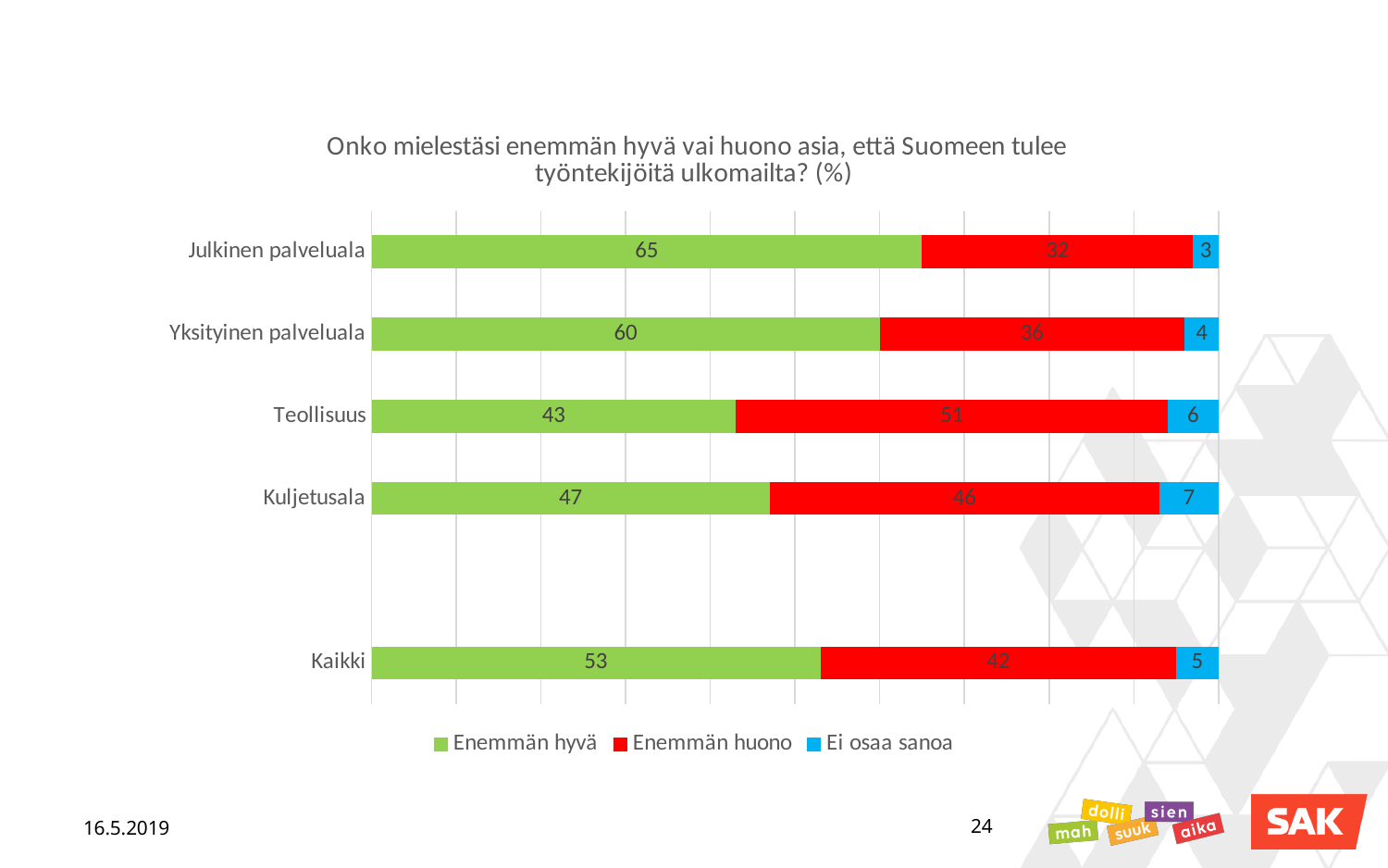
What is the value of "Enemmän huono" for Teollisuus? 51 What is the value of "Ei osaa sanoa" for Kuljetusala? 7 Which category has the highest "Enemmän hyvä" value? Julkinen palveluala What kind of chart is shown on the slide? Stacked bar chart Which category has the lowest "Enemmän hyvä" value? Teollisuus What is the total of the stacked bar for Kaikki? 100 What is the value of "Enemmän hyvä" for Kaikki? 53 How many series does the legend list? 3 Which is larger: the "Enemmän hyvä" value for Yksityinen palveluala or for Kuljetusala? Yksityinen palveluala How many categories are shown on the chart? 5 What is the value of "Enemmän hyvä" for Julkinen palveluala? 65 What is the difference between the "Enemmän huono" values for Teollisuus and Julkinen palveluala? 19